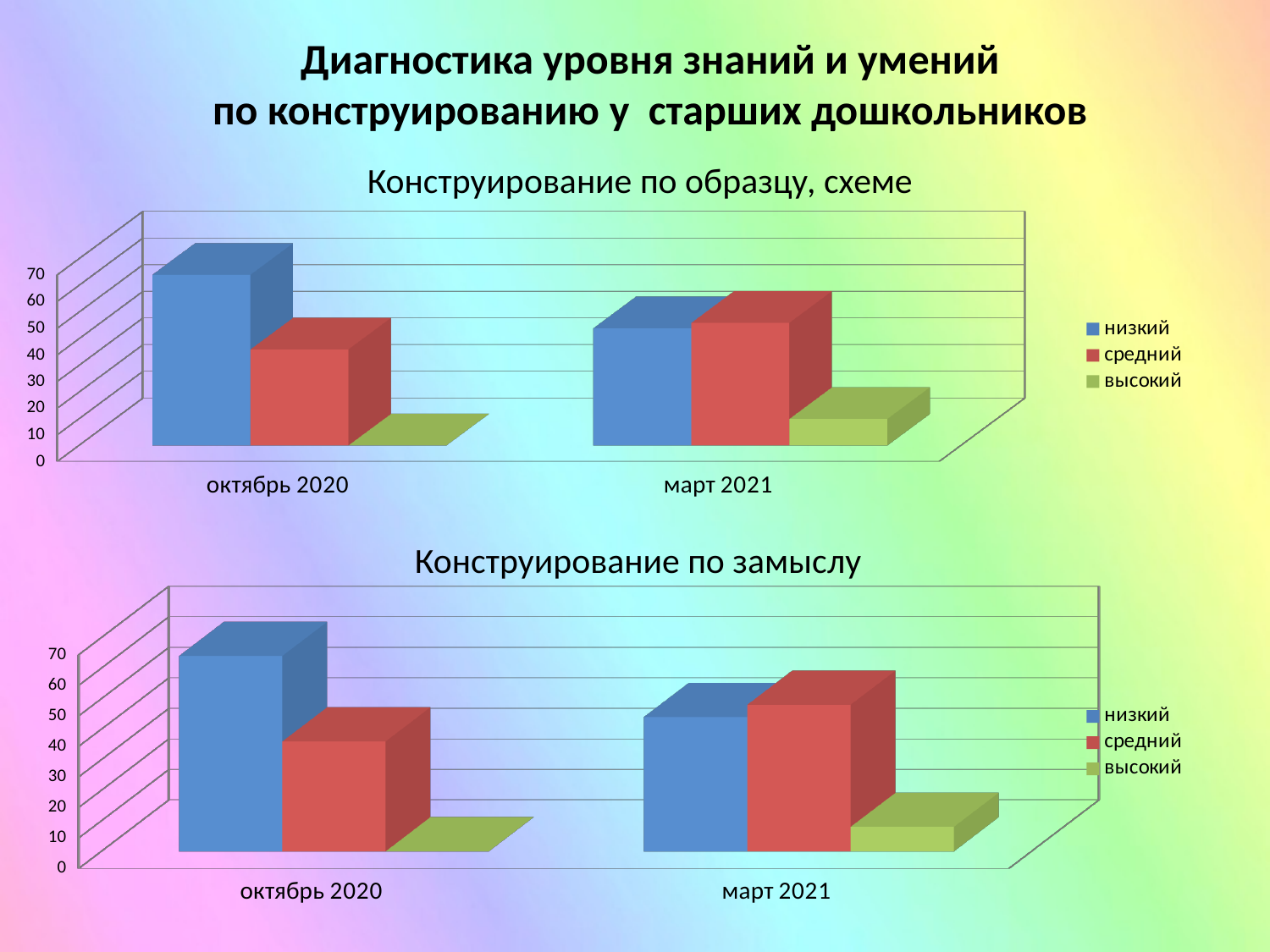
What kind of chart is the top chart titled "Конструирование по образцу, схеме"? bar chart In the top chart "Конструирование по образцу, схеме", is the value for низкий in октябрь 2020 greater or less than 50? greater In the top chart "Конструирование по образцу, схеме", does the value for низкий rise or fall from октябрь 2020 to март 2021? fall In the top chart "Конструирование по образцу, схеме", which series has the highest value for октябрь 2020? низкий In the bottom chart "Конструирование по замыслу", does the value for высокий rise or fall from октябрь 2020 to март 2021? rise In the bottom chart "Конструирование по замыслу", which is larger for октябрь 2020: низкий or средний? низкий In the bottom chart "Конструирование по замыслу", is the value for средний in октябрь 2020 greater or less than 20? greater In the top chart "Конструирование по образцу, схеме", is the value for высокий in март 2021 greater or less than 30? less In the bottom chart "Конструирование по замыслу", which series has the lowest value for март 2021? высокий How many series does the legend of the top chart "Конструирование по образцу, схеме" list? 3 How many categories are shown on the x axis of the bottom chart "Конструирование по замыслу"? 2 What colour represents the series средний in the legend of the top chart "Конструирование по образцу, схеме"? red